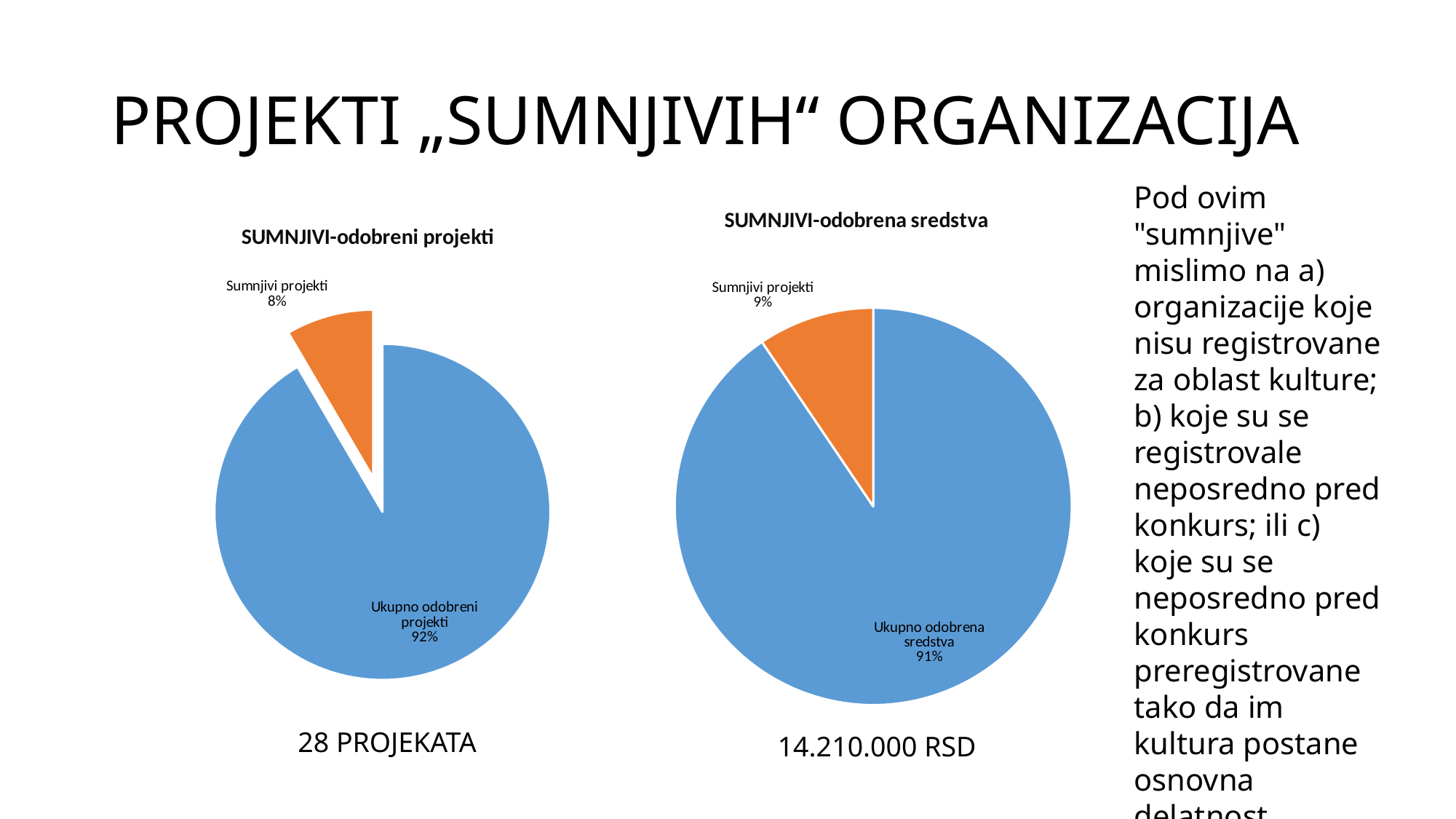
In the chart titled "SUMNJIVI-odobrena sredstva", which is larger, "Sumnjivi projekti" or "Ukupno odobrena sredstva"? Ukupno odobrena sredstva What is the title of the left chart on the slide? SUMNJIVI-odobreni projekti In the chart titled "SUMNJIVI-odobrena sredstva", what colour is the "Sumnjivi projekti" slice? Orange In the chart titled "SUMNJIVI-odobrena sredstva", what share of the pie is "Sumnjivi projekti"? 9% How many slices does the chart titled "SUMNJIVI-odobrena sredstva" have? 2 In the chart titled "SUMNJIVI-odobreni projekti", what share of the pie is "Ukupno odobreni projekti"? 92% In the chart titled "SUMNJIVI-odobrena sredstva", which slice is the smallest? Sumnjivi projekti In the chart titled "SUMNJIVI-odobreni projekti", which slice is the largest? Ukupno odobreni projekti In the chart titled "SUMNJIVI-odobreni projekti", what is the difference in percentage points between the "Ukupno odobreni projekti" slice and the "Sumnjivi projekti" slice? 84 In the chart titled "SUMNJIVI-odobreni projekti", what share of the pie is "Sumnjivi projekti"? 8% What kind of chart is the chart titled "SUMNJIVI-odobreni projekti"? Pie chart